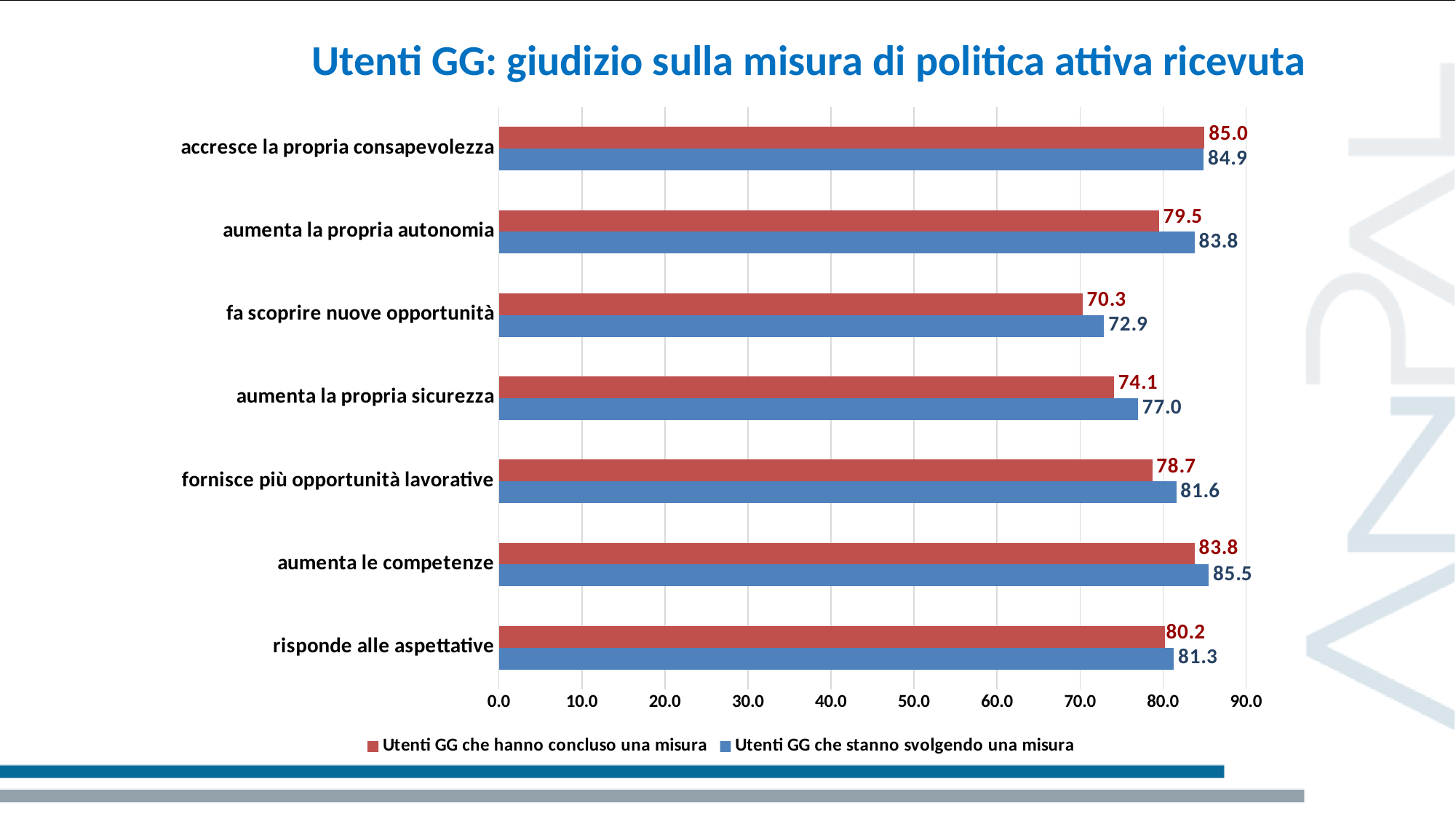
What is the value for "fa scoprire nuove opportunità" in the "Utenti GG che stanno svolgendo una misura" series? 72.9 Which category has the lowest value in the "Utenti GG che hanno concluso una misura" series? fa scoprire nuove opportunità What is the title of the chart? Utenti GG: giudizio sulla misura di politica attiva ricevuta For "aumenta la propria sicurezza", which series has the larger value? Utenti GG che stanno svolgendo una misura Is the value for "fornisce più opportunità lavorative" in the "Utenti GG che stanno svolgendo una misura" series greater or less than 80.0? greater What is the value for "aumenta la propria autonomia" in the "Utenti GG che hanno concluso una misura" series? 79.5 How many categories are shown on the chart? 7 Which category has the highest value in the "Utenti GG che stanno svolgendo una misura" series? aumenta le competenze How many series does the legend list? 2 What is the value for "risponde alle aspettative" in the "Utenti GG che hanno concluso una misura" series? 80.2 What is the difference between the two series for "aumenta la propria autonomia"? 4.3 What kind of chart is shown on the slide? bar chart